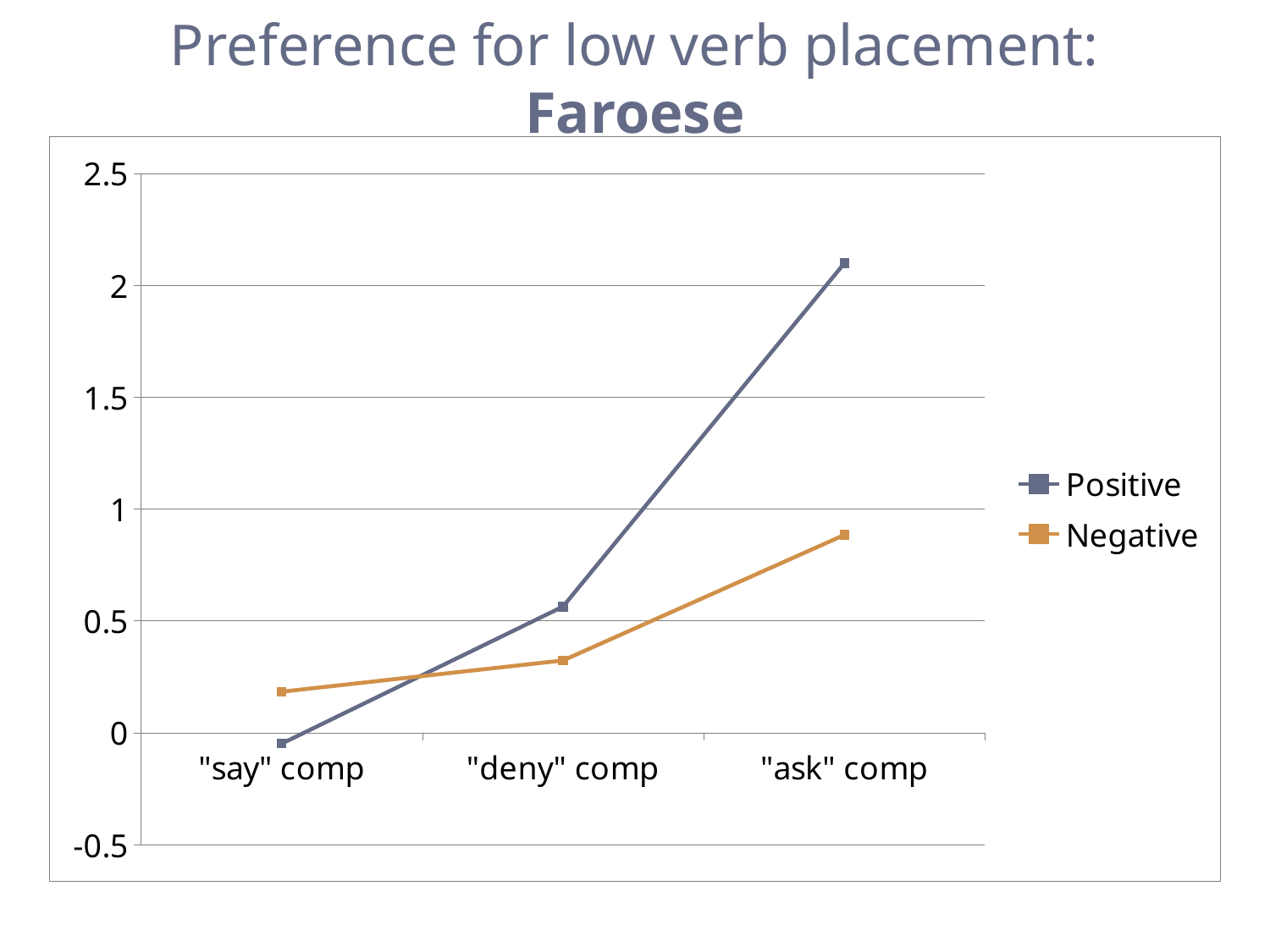
Do the values for the Positive series rise or fall from "say" comp to "ask" comp? rise Which series are listed in the legend? Positive and Negative For which category is the Positive series lowest? "say" comp Is the value for the Positive series at "ask" comp greater or less than 1.5? greater What kind of chart is shown on the slide? line chart How many series does the legend list? 2 What is the title of the chart? Preference for low verb placement: Faroese For which category is the Positive series highest? "ask" comp At "ask" comp, which series has the larger value, Positive or Negative? Positive Do the values for the Negative series rise or fall from "say" comp to "ask" comp? rise Is the value for the Negative series at "ask" comp greater or less than 1? less How many categories are shown on the x axis? 3